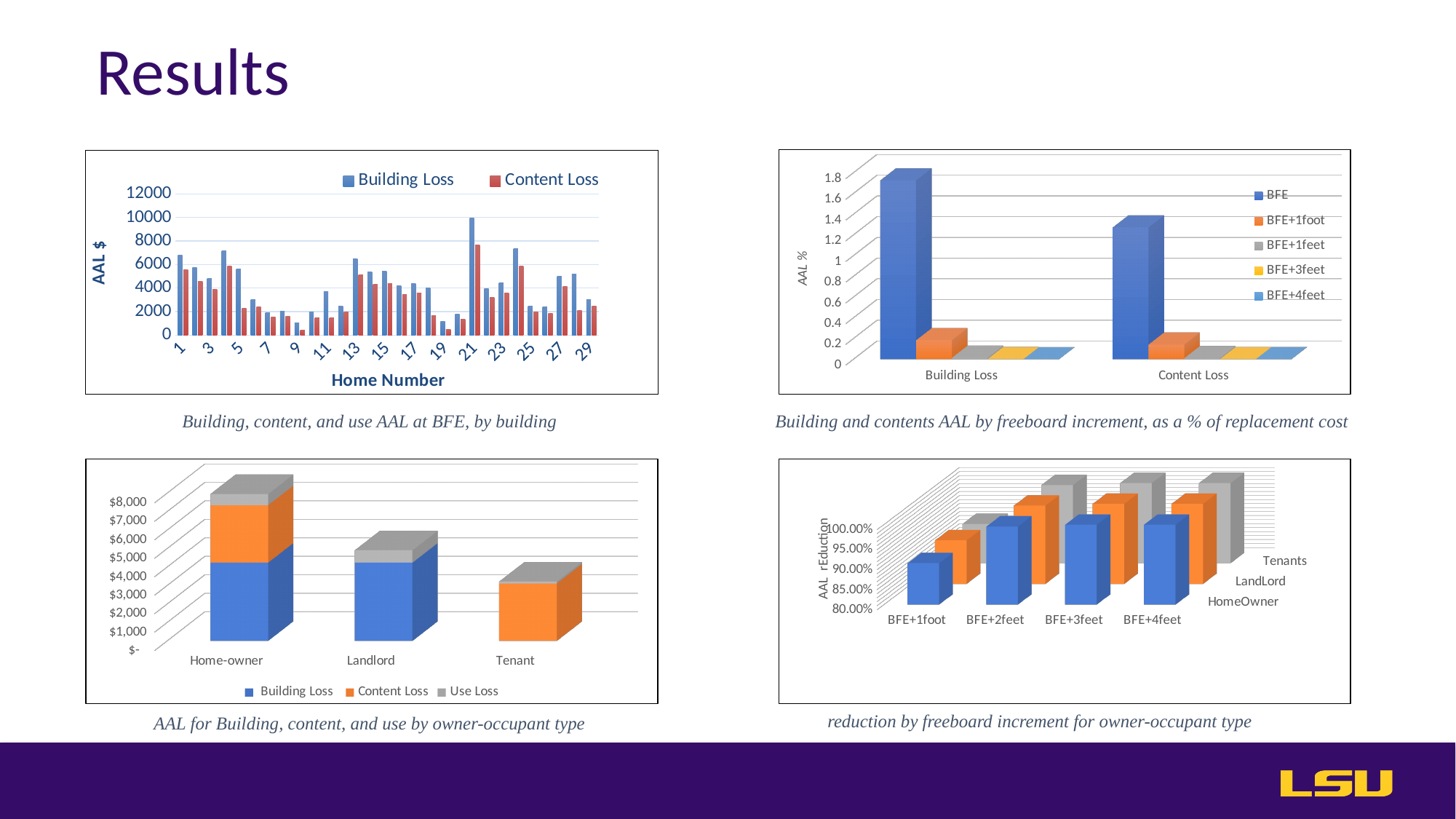
In the top-left chart (AAL $ by Home Number), how many series does the legend list? 2 In the top-right chart (Building and contents AAL by freeboard increment), is the BFE value for Building Loss greater or less than 1.4? greater In the top-right chart (Building and contents AAL by freeboard increment), which series has the highest value for Content Loss? BFE In the bottom-left chart (AAL for Building, content, and use by owner-occupant type), which owner-occupant type has the lowest total stacked bar? Tenant In the top-right chart (Building and contents AAL by freeboard increment), how many series does the legend list? 5 In the top-right chart (Building and contents AAL by freeboard increment), which category has the larger BFE value, Building Loss or Content Loss? Building Loss In the bottom-left chart (AAL for Building, content, and use by owner-occupant type), how many owner-occupant categories are shown on the x axis? 3 In the top-left chart (AAL $ by Home Number), is the Building Loss for home 21 greater or less than 8000? greater In the bottom-right chart (reduction by freeboard increment for owner-occupant type), how many freeboard increments are shown on the x axis? 4 In the top-left chart (AAL $ by Home Number), which home number has the highest Building Loss? 21 In the top-left chart (Building, content, and use AAL at BFE, by building), what kind of chart is shown? bar chart In the bottom-left chart (AAL for Building, content, and use by owner-occupant type), which owner-occupant type has the highest total stacked bar? Home-owner